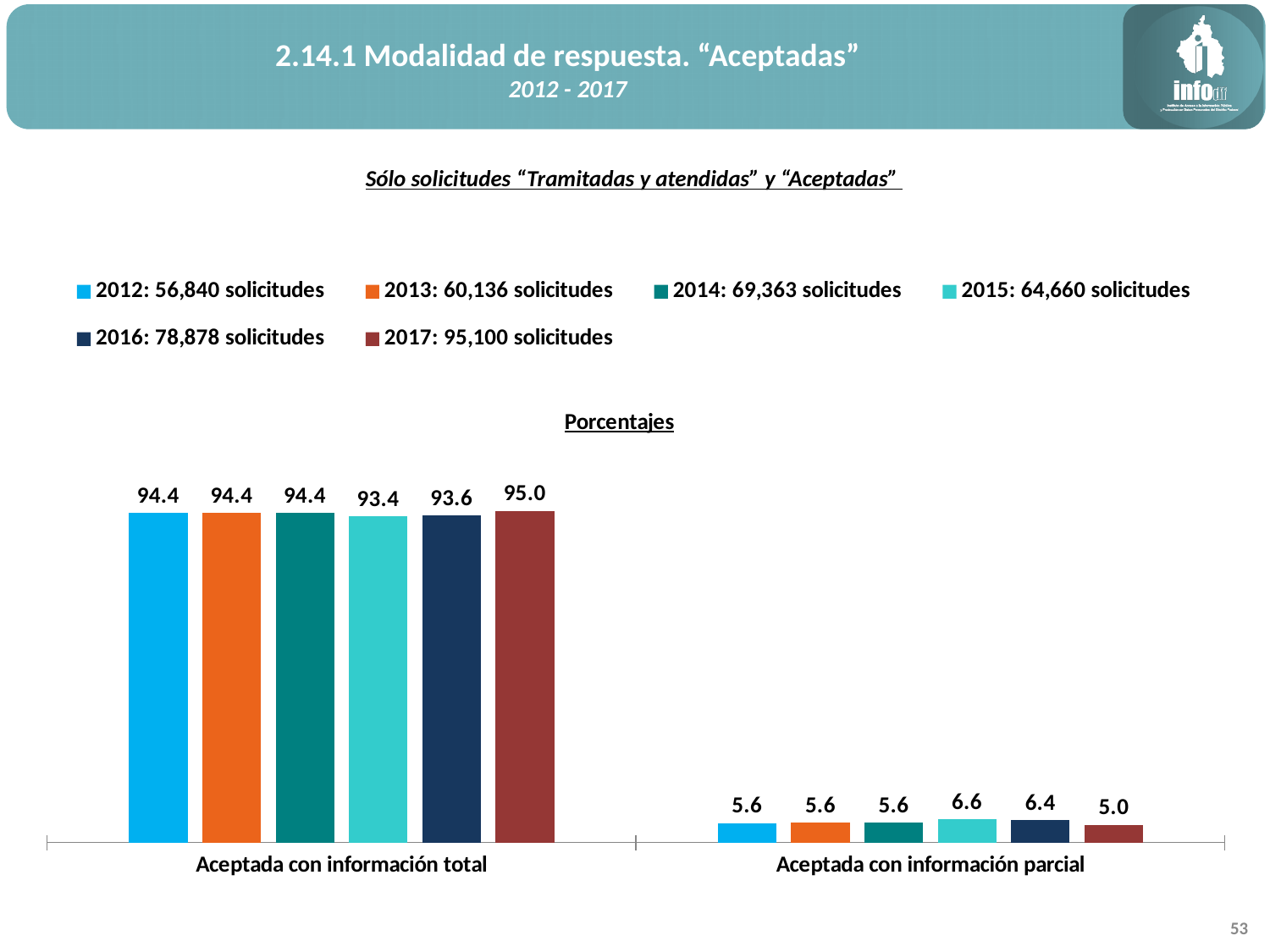
What is the value for 2017 in the "Aceptada con información total" category? 95.0 According to the legend, how many solicitudes were there in 2017? 95,100 solicitudes How many categories are shown on the x axis? 2 What is the value for 2015 in the "Aceptada con información parcial" category? 6.6 What is the value for 2012 in the "Aceptada con información total" category? 94.4 What kind of chart is shown on the slide? Bar chart What is the difference between the 2017 and 2015 values in the "Aceptada con información total" category? 1.6 Which year has the lowest value in the "Aceptada con información parcial" category? 2017 What is the difference between the 2016 and 2017 values in the "Aceptada con información parcial" category? 1.4 Which is larger in the "Aceptada con información parcial" category: the value for 2015 or the value for 2016? 2015 How many series does the legend list? 6 Which year has the highest value in the "Aceptada con información total" category? 2017